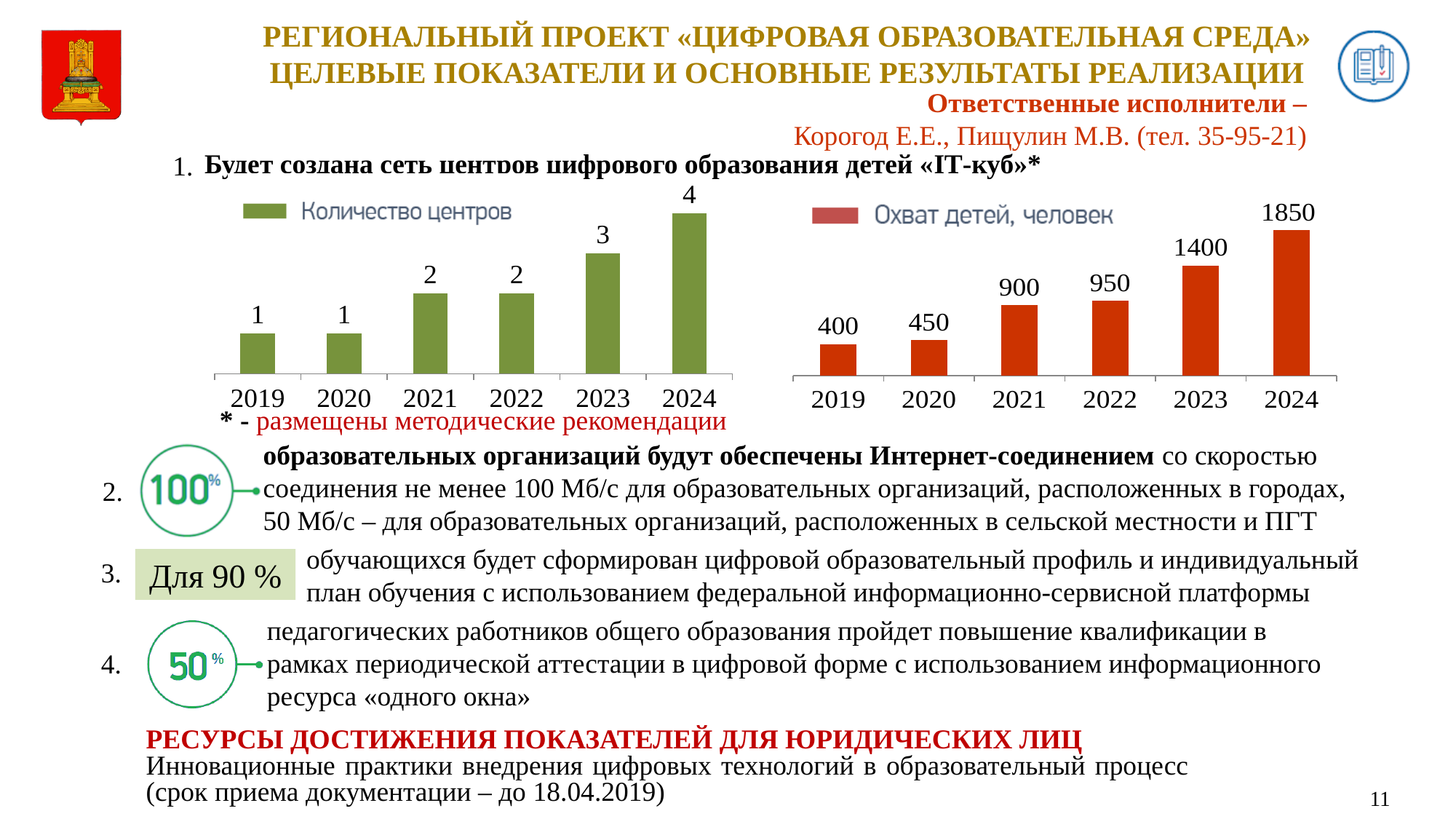
In the right chart (Охват детей, человек), what is the value for 2019? 400 How many years are shown on the x axis of the left chart (Количество центров)? 6 In the right chart (Охват детей, человек), which year has the highest value? 2024 In the left chart (Количество центров), what is the value for 2024? 4 In the right chart (Охват детей, человек), what is the value for 2021? 900 What is the legend entry of the left chart? Количество центров In the left chart (Количество центров), which year has the lowest value, 2019 or 2023? 2019 What kind of chart is the right chart (Охват детей, человек)? bar chart In the right chart (Охват детей, человек), which is larger, the value for 2020 or the value for 2022? 2022 In the left chart (Количество центров), what is the difference between the values for 2023 and 2020? 2 In the right chart (Охват детей, человек), do the values rise or fall from 2019 to 2024? rise In the right chart (Охват детей, человек), what is the difference between the values for 2024 and 2023? 450